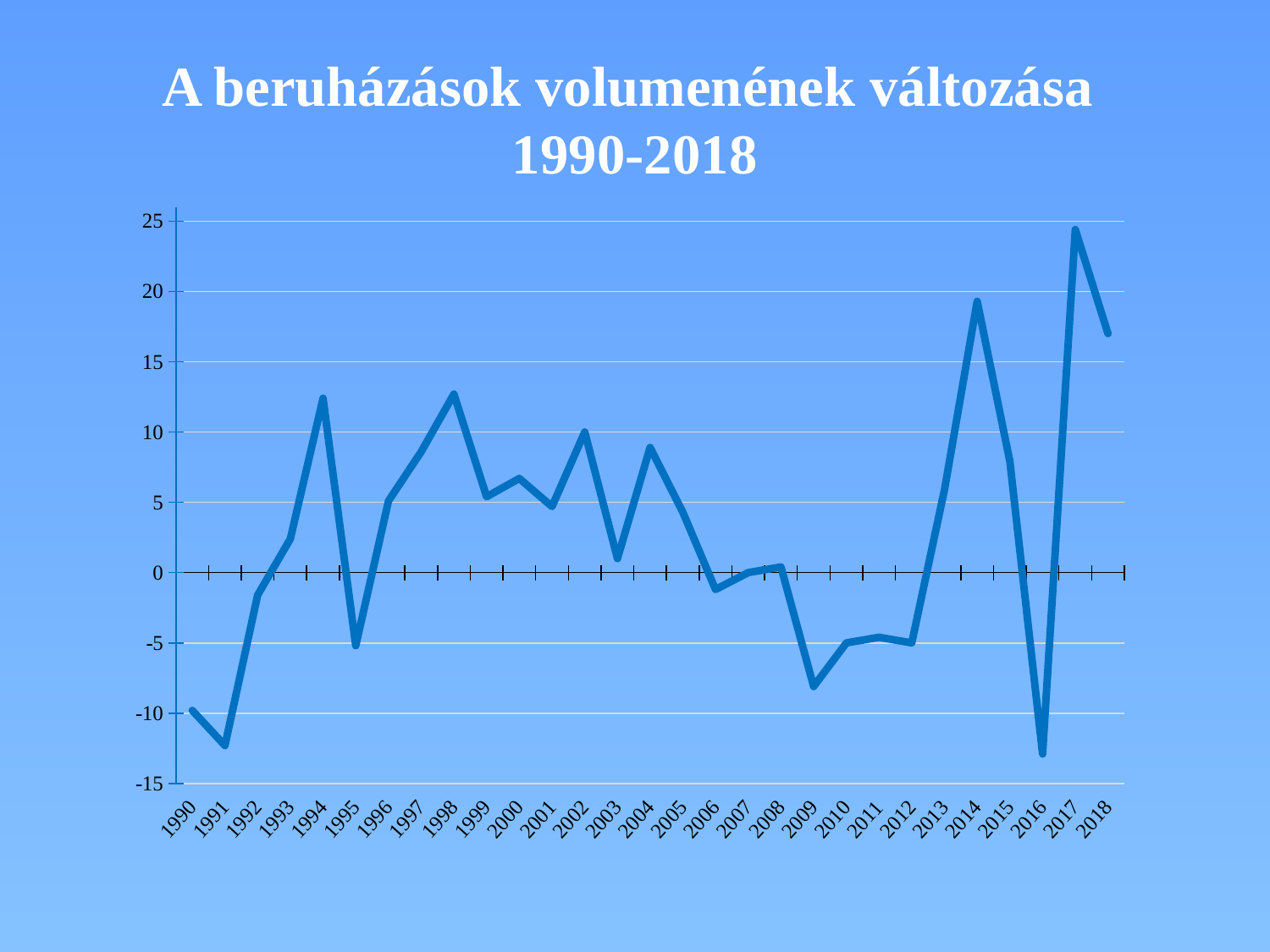
Which is larger, the value for 2017 or the value for 2014? 2017 Which year has the highest value on the chart? 2017 Which is larger, the value for 2009 or the value for 2010? 2010 What kind of chart is shown on the slide? line chart How many years (data points) are plotted on the x axis? 29 Is the value for 2009 greater or less than -5? less Is the value for 1994 greater or less than 10? greater Do the values rise or fall from 2014 to 2016? fall What is the title of the chart? A beruházások volumenének változása 1990-2018 Is the value for 1995 greater or less than 0? less